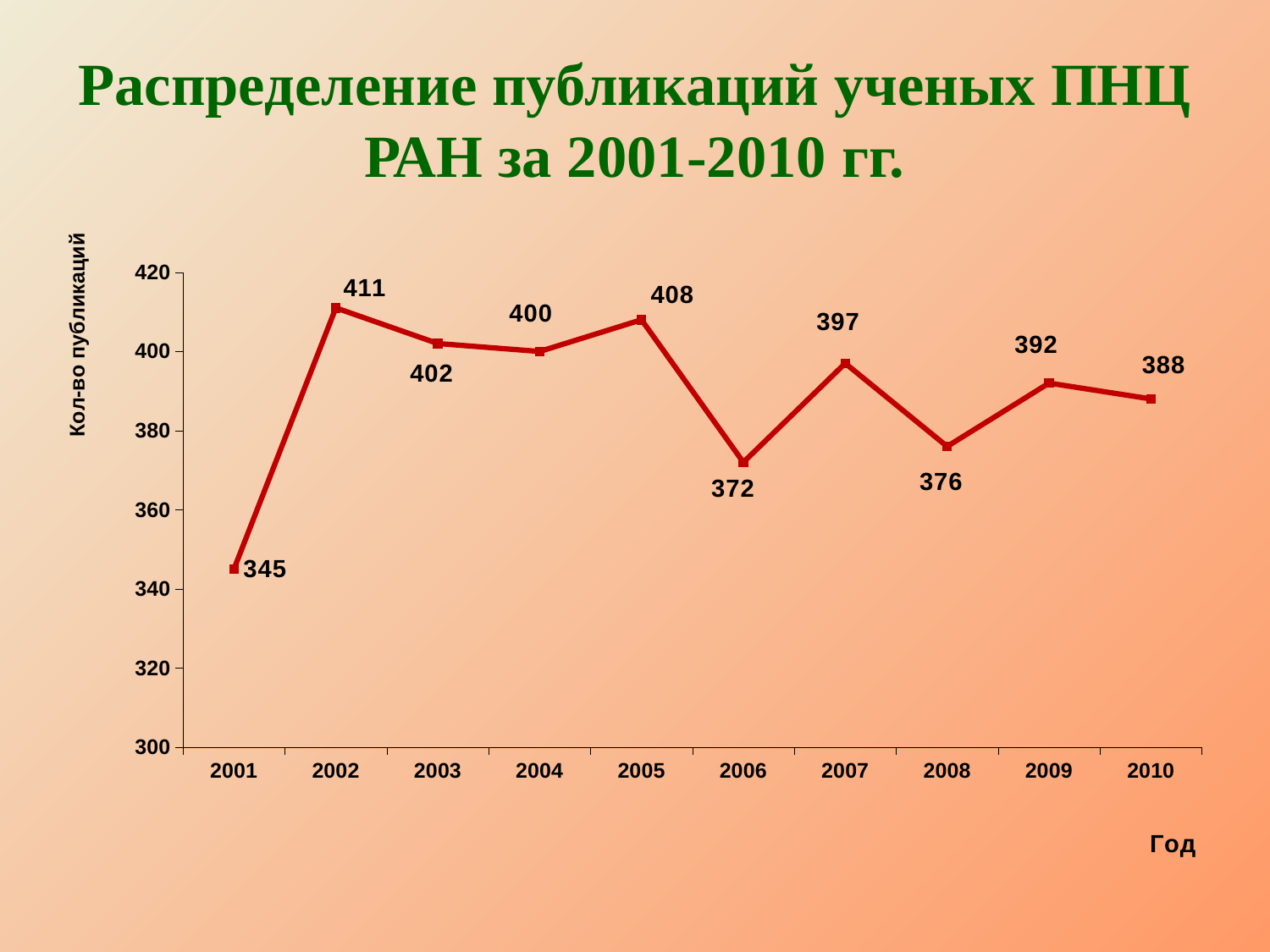
What is the difference between the values for 2007 and 2006? 25 Which is larger, the value for 2003 or the value for 2004? 2003 What is the label of the vertical axis? Кол-во публикаций How many publications were there in 2001? 345 Which year has the highest number of publications? 2002 How many years are plotted on the chart? 10 What is the value for 2005? 408 What is the value for 2010? 388 What is the difference between the values for 2002 and 2001? 66 Which year has the lowest number of publications? 2001 What type of chart is shown on the slide? line chart Does the value rise or fall from 2005 to 2006? fall